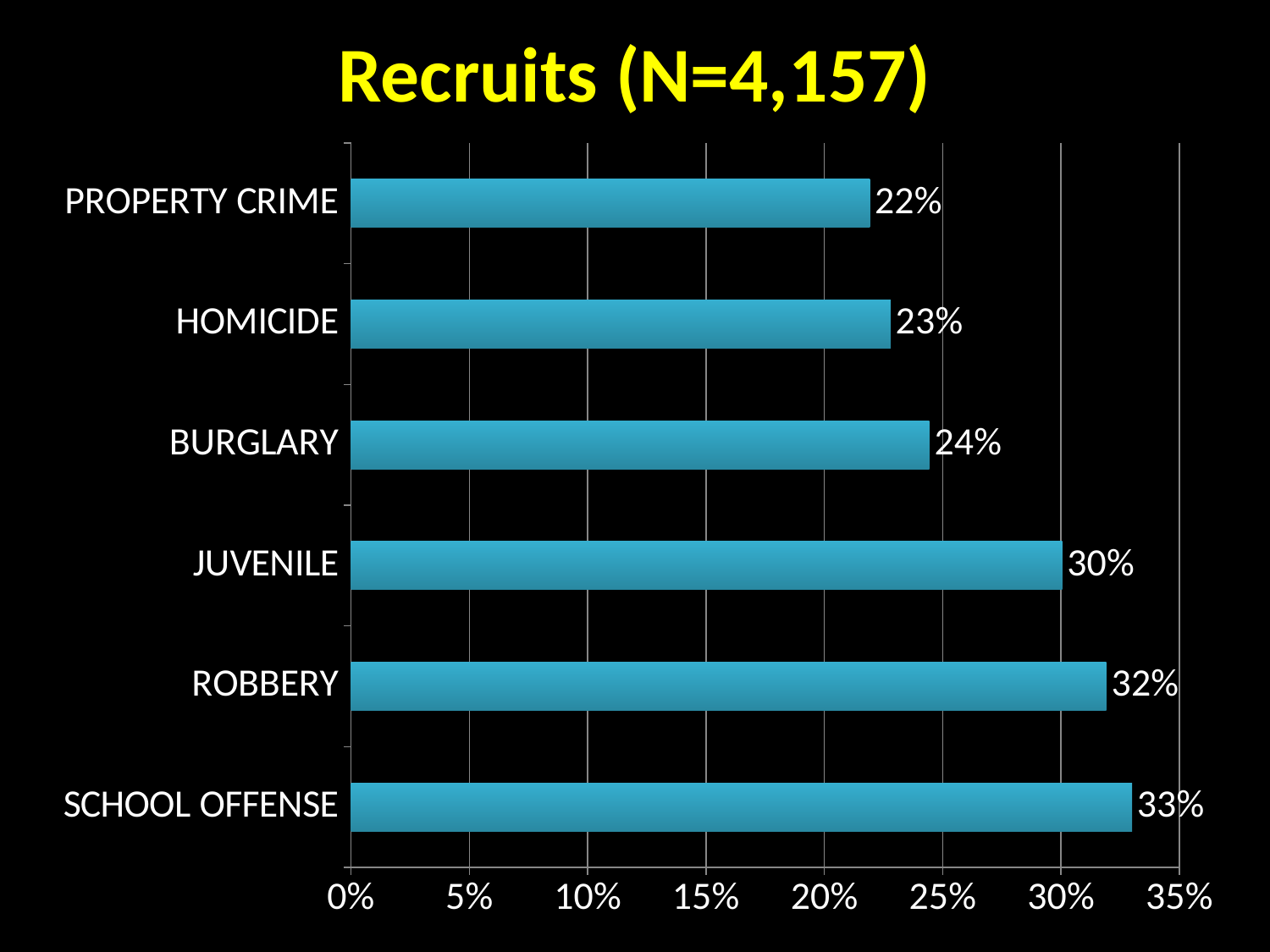
What is the value for SCHOOL OFFENSE? 33% What is the value for JUVENILE? 30% What kind of chart is shown on the slide? bar chart Which category has the lowest value? PROPERTY CRIME What is the value for PROPERTY CRIME? 22% What is the maximum value shown on the horizontal axis? 35% Is the value for ROBBERY greater or less than 30%? greater How many categories are shown in the chart? 6 Which category has the highest value? SCHOOL OFFENSE What is the difference between the values for ROBBERY and BURGLARY? 8% Which is larger, the value for HOMICIDE or the value for JUVENILE? JUVENILE What is the title of the chart? Recruits (N=4,157)